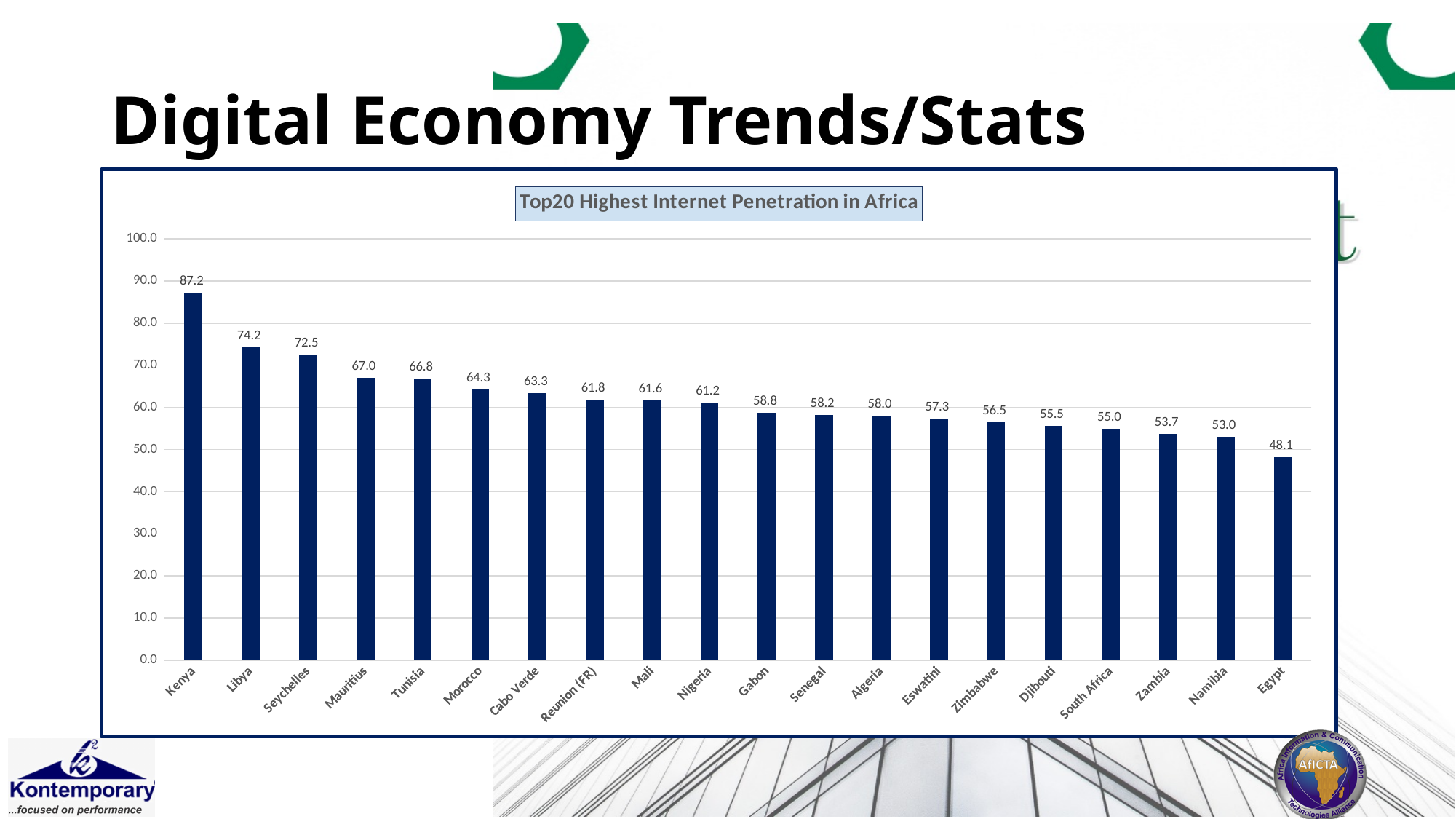
Which country has the lowest value? Egypt Is the value for Seychelles greater or less than 70.0? greater What is the title of the chart? Top20 Highest Internet Penetration in Africa Which country has the highest value? Kenya What is the value for Nigeria? 61.2 What is the difference between the values for Kenya and Libya? 13.0 What is the value for South Africa? 55.0 Which has a larger value, Morocco or Gabon? Morocco What is the value for Kenya? 87.2 What kind of chart is this? Bar chart What is the difference between the values for Mauritius and Egypt? 18.9 How many countries are shown on the chart? 20